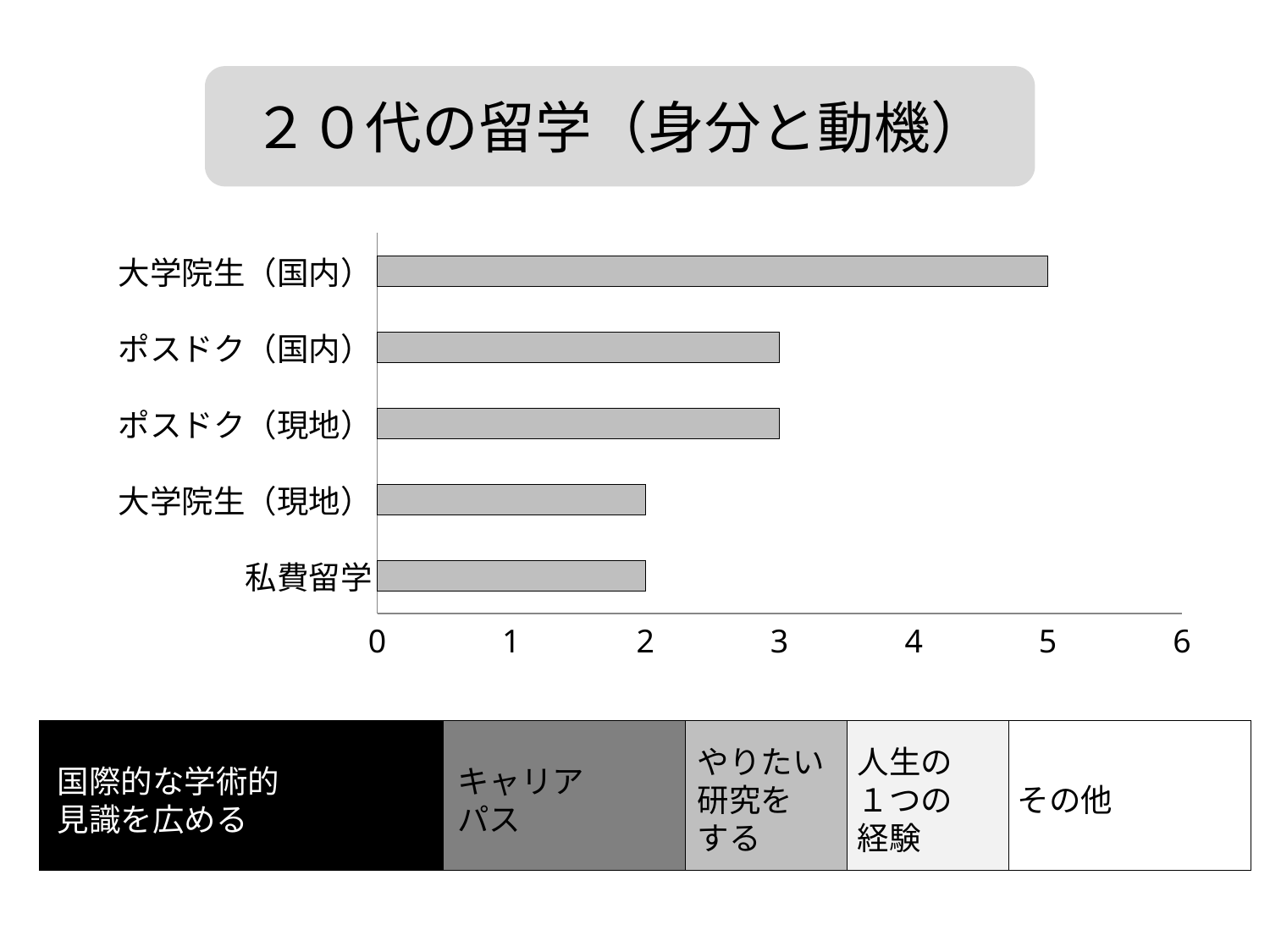
What is the value for ポスドク（現地） in the bar chart? 3 Is the value for 大学院生（国内） greater or less than 4? greater How many categories are shown in the bar chart? 5 What is the difference between the values for 大学院生（国内） and ポスドク（国内）? 2 Which is larger, the value for 大学院生（国内） or the value for 大学院生（現地）? 大学院生（国内） Which category has the highest value in the bar chart? 大学院生（国内） What is the difference between the values for ポスドク（現地） and 私費留学? 1 What kind of chart is shown on the slide? bar chart What is the value for ポスドク（国内） in the bar chart? 3 What is the value for 大学院生（現地） in the bar chart? 2 What is the value for 大学院生（国内） in the bar chart? 5 What is the value for 私費留学 in the bar chart? 2